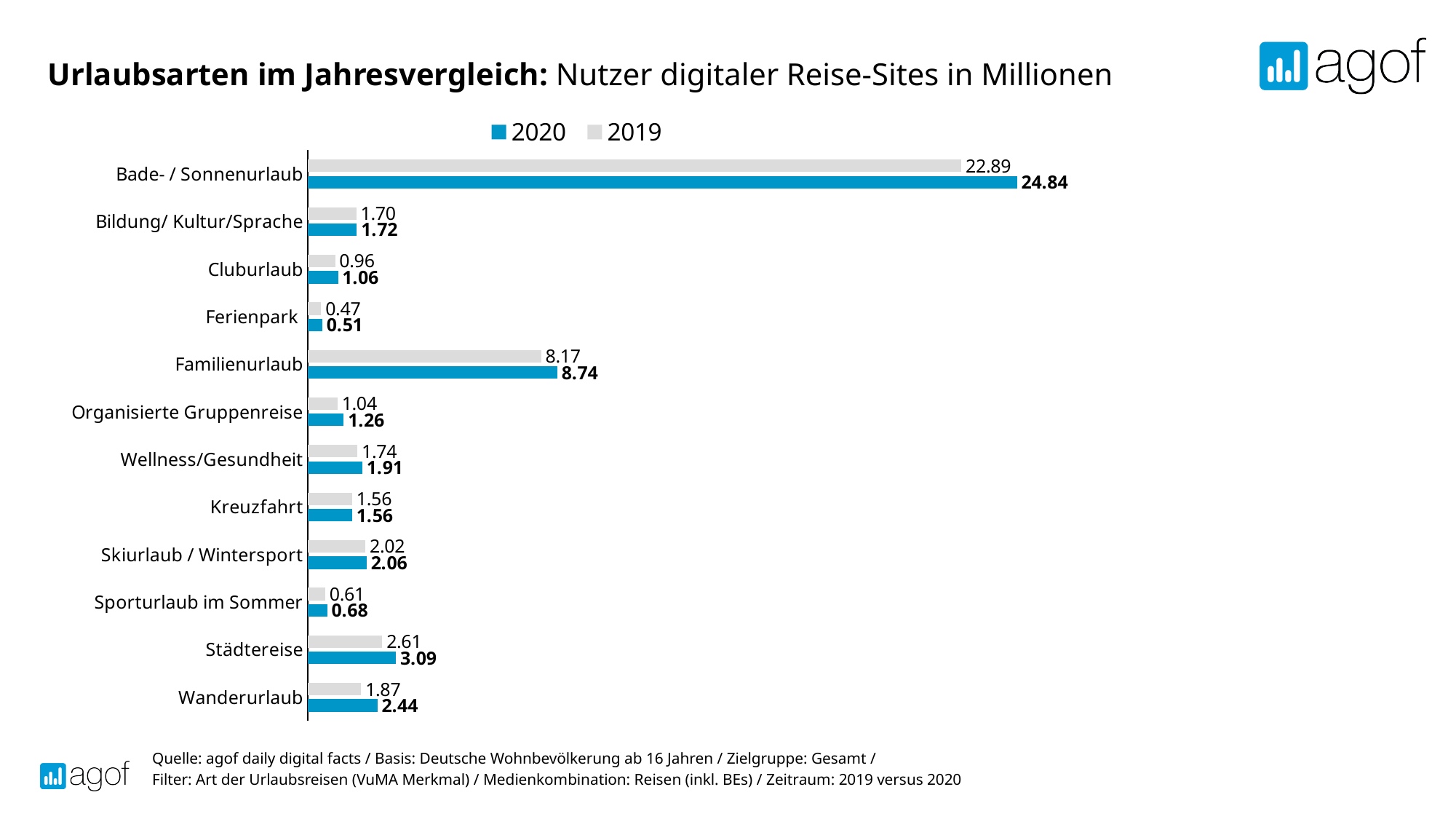
What is the 2019 value for Städtereise? 2.61 What is the 2020 value for Wanderurlaub? 2.44 What kind of chart is shown on the slide? Bar chart Which colour represents the 2019 series in the chart? Grey Which category has the highest 2020 value? Bade- / Sonnenurlaub Which is larger: the 2020 value for Städtereise or the 2020 value for Skiurlaub / Wintersport? Städtereise What is the difference between the 2020 and 2019 values for Bade- / Sonnenurlaub? 1.95 Which category has the lowest 2019 value? Ferienpark How many series does the legend list? 2 What is the difference between the 2020 and 2019 values for Wanderurlaub? 0.57 What is the 2020 value for Familienurlaub? 8.74 How many holiday-type categories are shown in the chart? 12